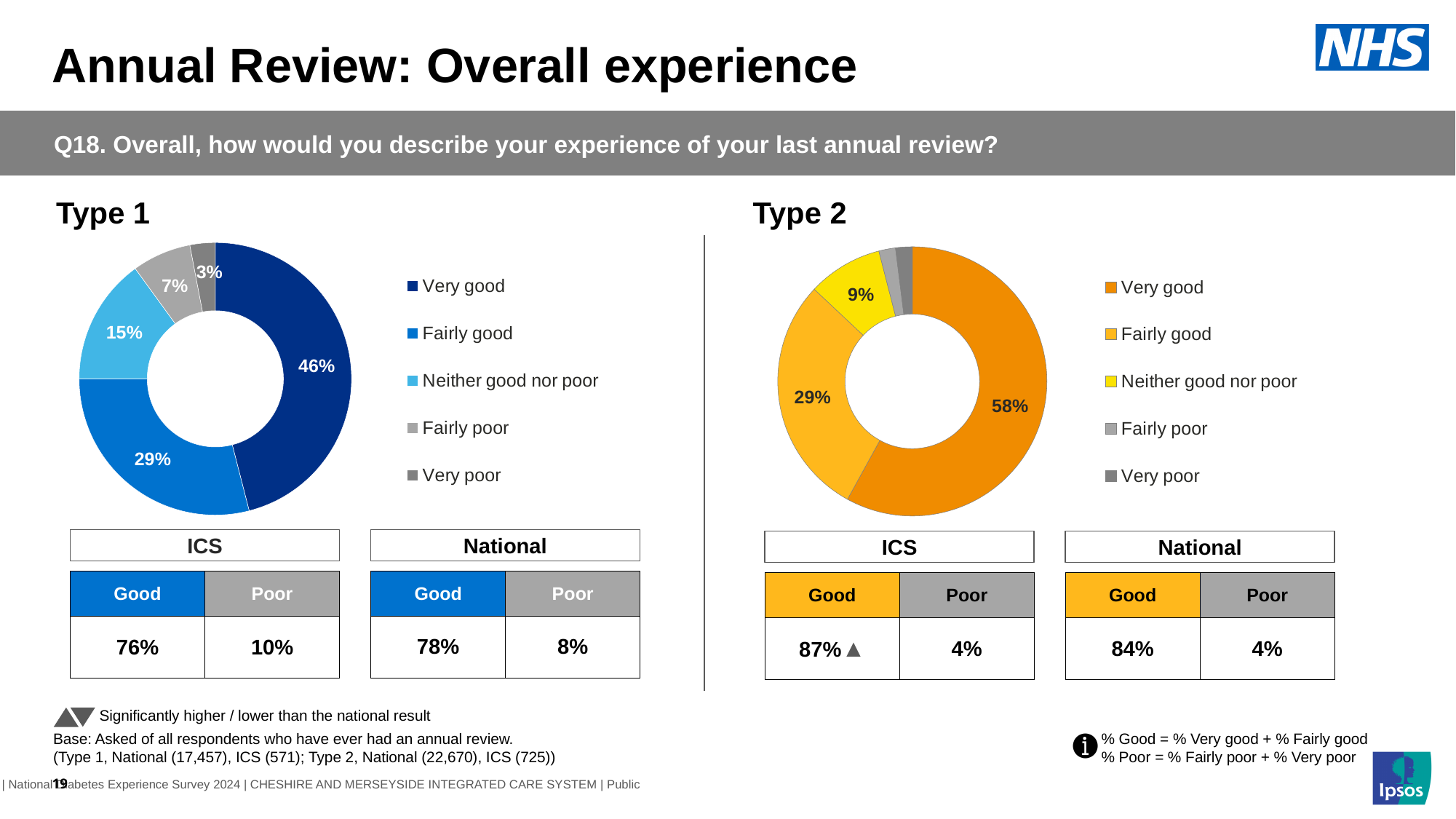
Which chart shows a larger share for Very good, Type 1 or Type 2? Type 2 In the Type 2 chart, what percentage of respondents said their experience was Very good? 58% What kind of chart is used to show the Type 1 results? Doughnut (pie) chart In the Type 2 chart, what percentage of respondents said Neither good nor poor? 9% In the Type 1 chart, which response category has the largest share? Very good In the Type 1 chart, what is the difference in percentage points between Very good and Fairly good? 17 In the Type 2 chart, what colour is the Neither good nor poor segment? Yellow In the Type 1 chart, what percentage of respondents said their experience was Very good? 46% In the Type 1 chart, what percentage of respondents said Very poor? 3% In the Type 1 chart, what percentage of respondents said Neither good nor poor? 15% How many response categories does the legend of the Type 2 chart list? 5 In the Type 1 chart, which response category has the smallest share? Very poor